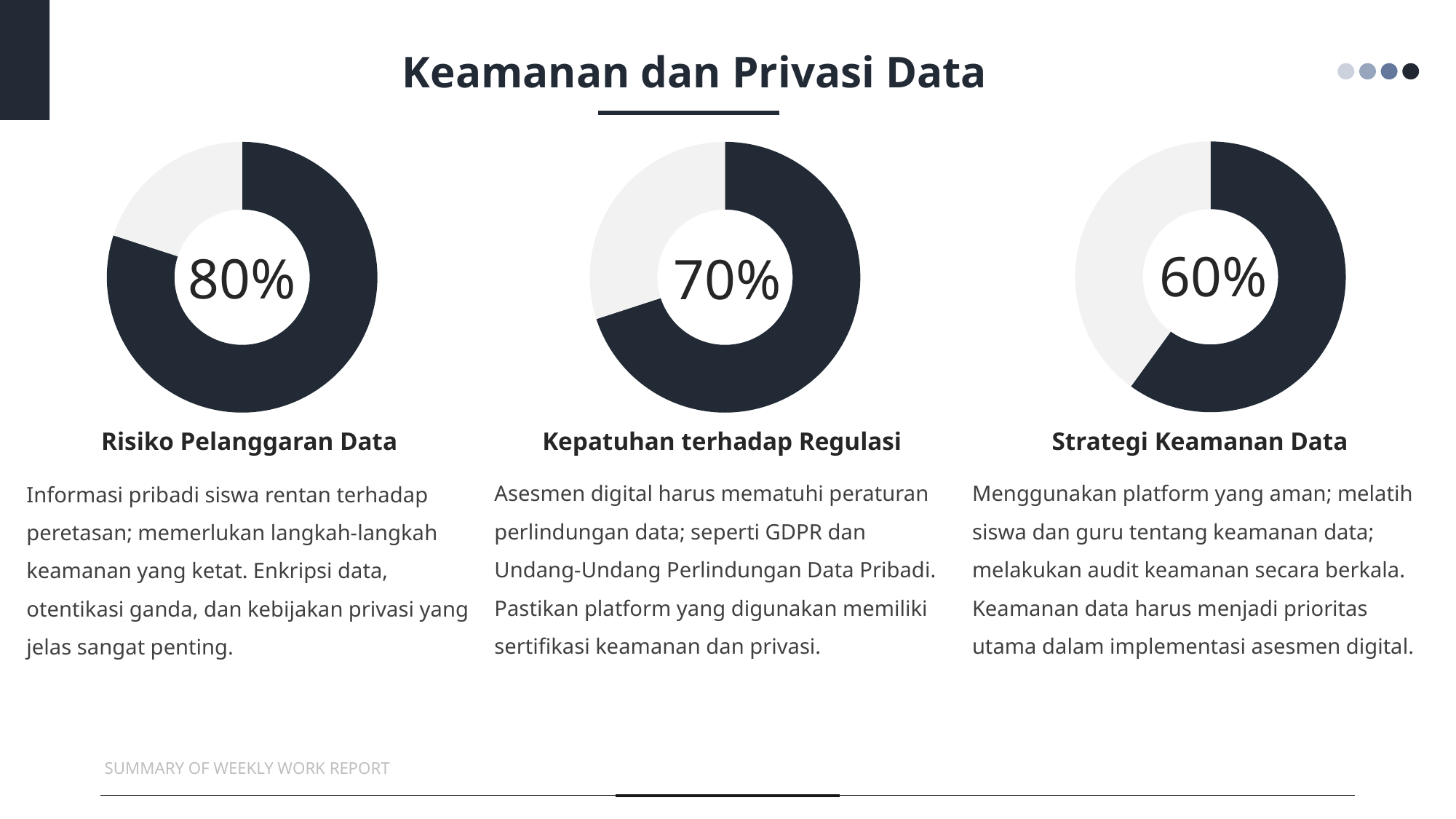
What is the difference between the percentage in the 'Kepatuhan terhadap Regulasi' chart and the 'Strategi Keamanan Data' chart? 10% Which of the three donut charts shows the highest percentage? Risiko Pelanggaran Data How many donut charts are shown on the slide? 3 In the 'Kepatuhan terhadap Regulasi' donut chart, what share of the ring is filled by the dark segment? 70% Which is larger: the percentage in the 'Kepatuhan terhadap Regulasi' chart or the 'Strategi Keamanan Data' chart? Kepatuhan terhadap Regulasi What value is shown in the centre of the 'Risiko Pelanggaran Data' donut chart? 80% Which of the three donut charts shows the lowest percentage? Strategi Keamanan Data What value is shown in the centre of the 'Strategi Keamanan Data' donut chart? 60% What is the difference between the percentage in the 'Risiko Pelanggaran Data' chart and the 'Strategi Keamanan Data' chart? 20% What value is shown in the centre of the 'Kepatuhan terhadap Regulasi' donut chart? 70% What kind of chart is used to display the percentages on this slide? Donut chart What is the title of the slide containing the three donut charts? Keamanan dan Privasi Data